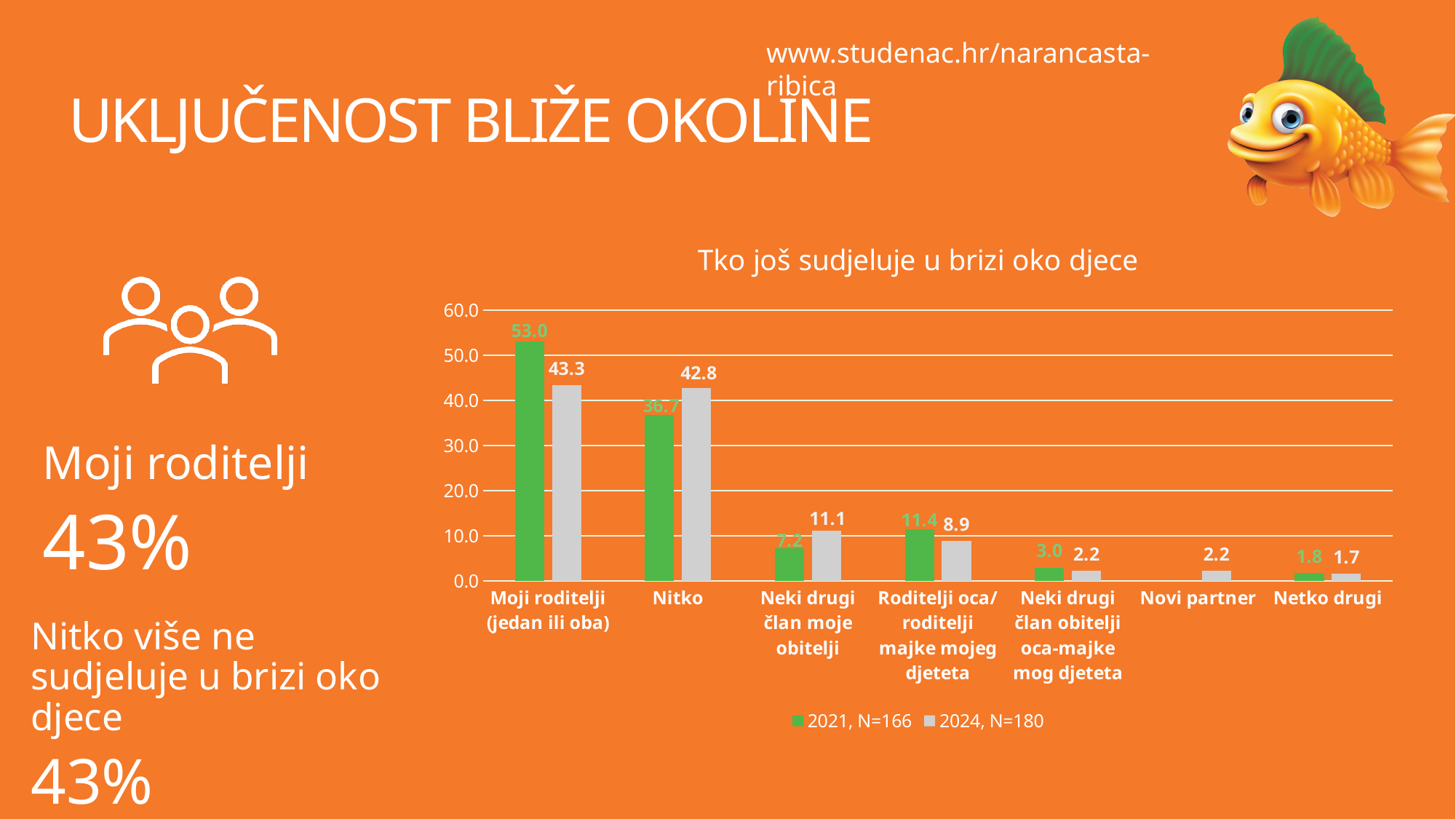
What is the 2024 value for 'Nitko'? 42.8 Which category has the lowest 2024 value? Netko drugi What is the difference between the 2021 and 2024 values for 'Moji roditelji (jedan ili oba)'? 9.7 What is the 2021 value for 'Moji roditelji (jedan ili oba)' in the chart 'Tko još sudjeluje u brizi oko djece'? 53.0 What type of chart is shown on the slide? Bar chart How many categories are shown on the x axis of the chart? 7 What is the title of the chart on the slide? Tko još sudjeluje u brizi oko djece Which category has the highest 2021 value? Moji roditelji (jedan ili oba) What is the 2021 value for 'Roditelji oca/roditelji majke mojeg djeteta'? 11.4 For 'Nitko', which is larger: the 2021 value or the 2024 value? 2024 What is the 2024 value for 'Neki drugi član moje obitelji'? 11.1 How many series does the chart legend list? 2